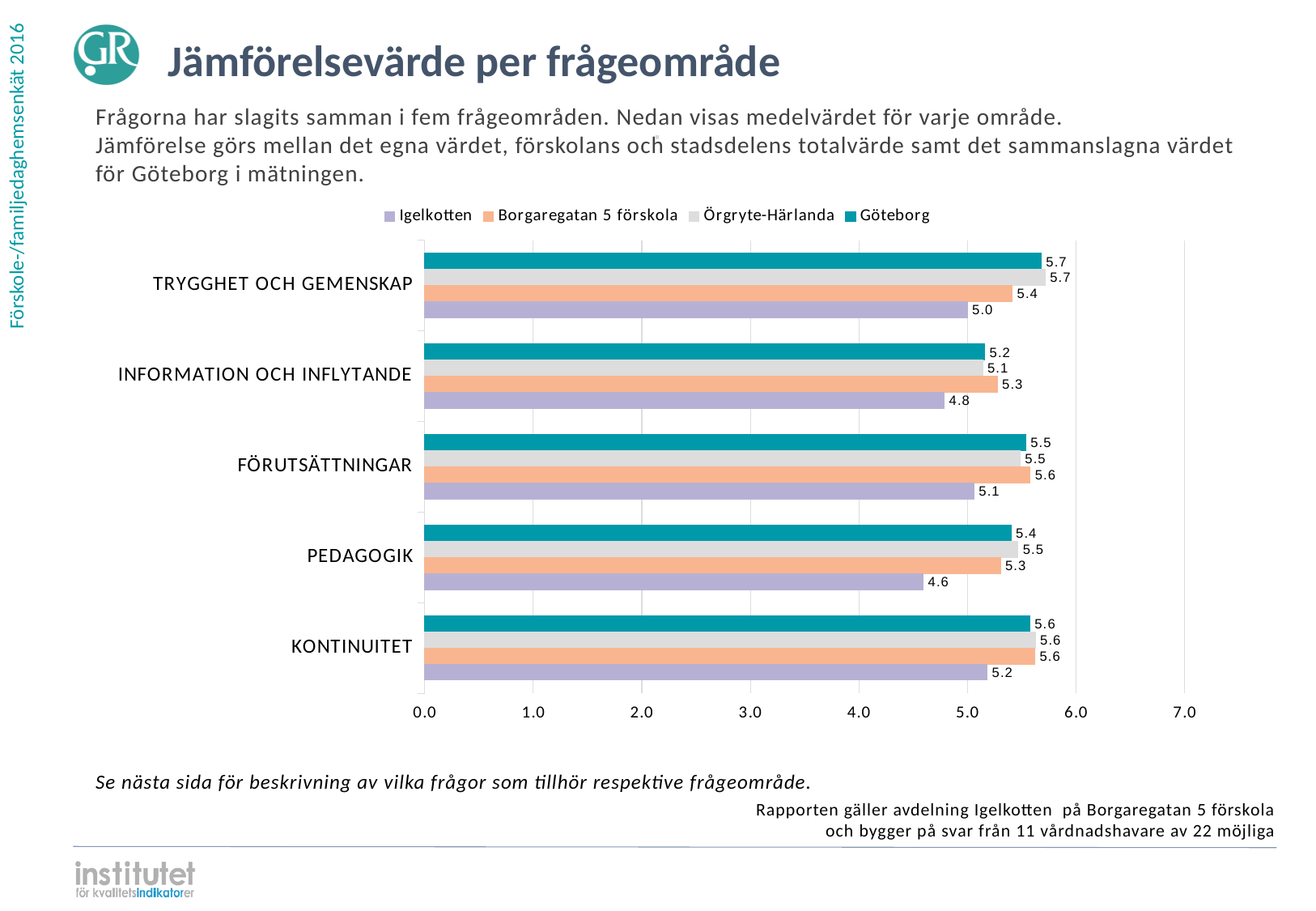
How many categories are shown on the chart? 5 In which category does Igelkotten have its highest value? KONTINUITET What is the value for Göteborg in the TRYGGHET OCH GEMENSKAP category? 5.7 In which category does Igelkotten have its lowest value? PEDAGOGIK What is the value for Örgryte-Härlanda in the FÖRUTSÄTTNINGAR category? 5.5 Which is larger in the INFORMATION OCH INFLYTANDE category: the value for Borgaregatan 5 förskola or the value for Igelkotten? Borgaregatan 5 förskola What is the value for Igelkotten in the PEDAGOGIK category? 4.6 How many series does the legend list? 4 What kind of chart is shown on the slide? Bar chart What is the difference between the Göteborg value and the Igelkotten value in the PEDAGOGIK category? 0.8 What is the value for Borgaregatan 5 förskola in the INFORMATION OCH INFLYTANDE category? 5.3 Which series is shown in teal on the chart? Göteborg